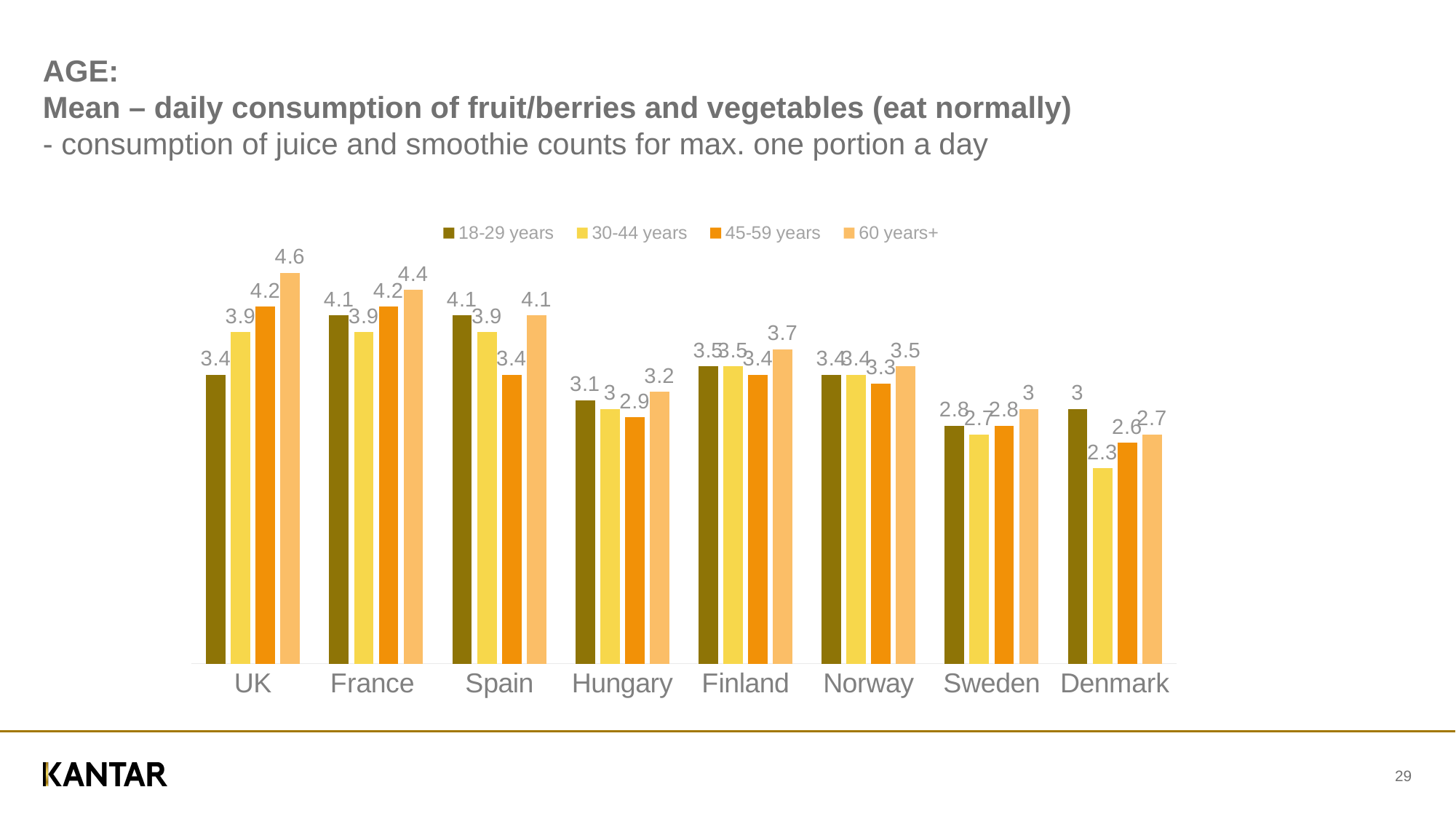
Which country has the highest value for the 60 years+ group? UK How many countries are shown on the x axis? 8 What is the value for the 45-59 years group in Spain? 3.4 Which is larger in Spain: the 18-29 years value or the 45-59 years value? 18-29 years What kind of chart is shown on the slide? Bar chart What is the value for the 60 years+ group in the UK? 4.6 What is the difference between the 60 years+ and 18-29 years values in the UK? 1.2 How many series does the legend list? 4 What is the value for the 30-44 years group in Denmark? 2.3 What is the value for the 18-29 years group in Hungary? 3.1 What is the difference between the 18-29 years and 30-44 years values in Denmark? 0.7 Which country has the lowest value for the 30-44 years group? Denmark